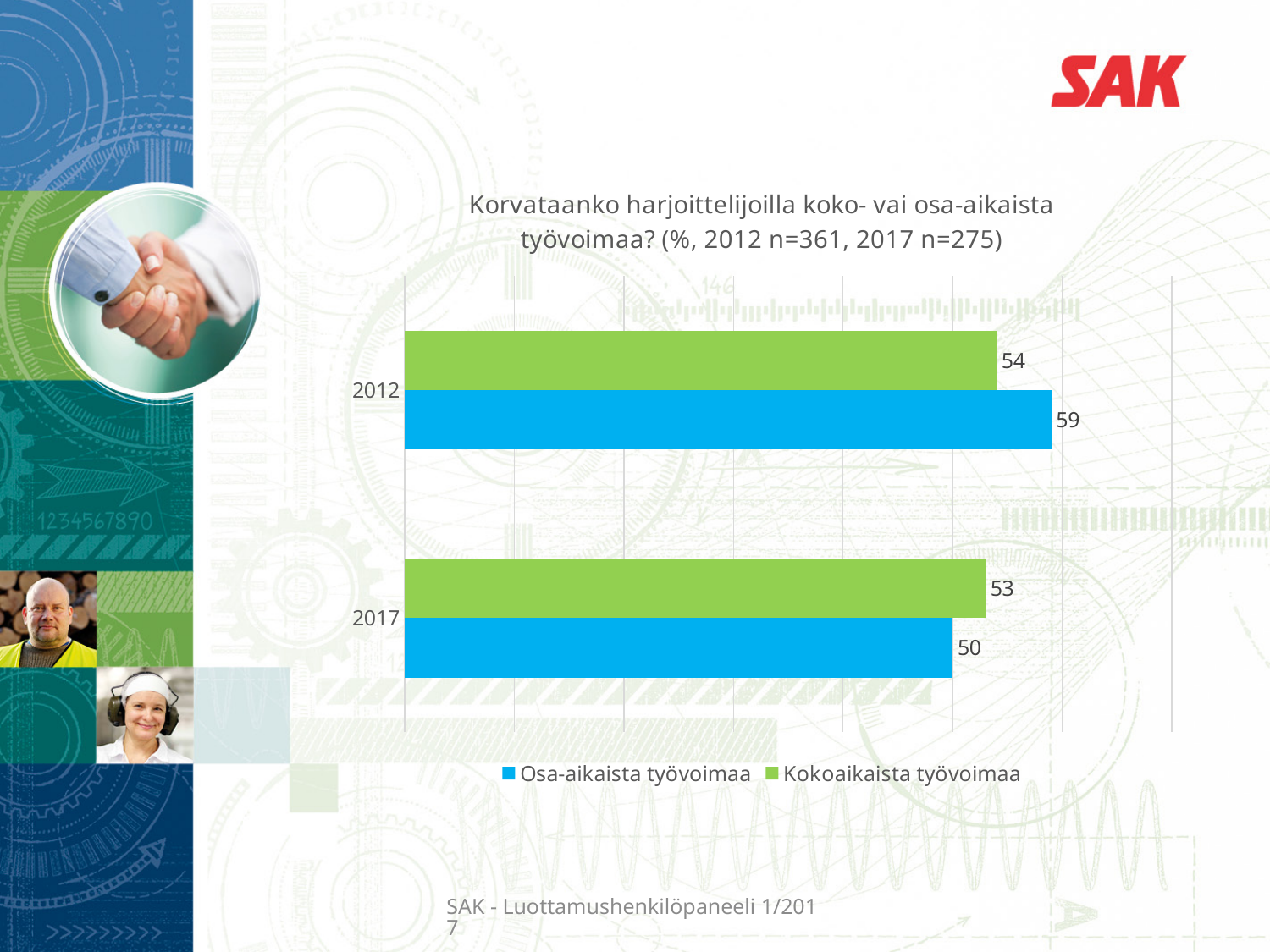
What kind of chart is shown on the slide? Bar chart How many series does the legend list? 2 How many year categories are shown on the chart? 2 What is the value for Osa-aikaista työvoimaa in 2017? 50 In 2017, which is larger: Osa-aikaista työvoimaa or Kokoaikaista työvoimaa? Kokoaikaista työvoimaa What is the difference between the Osa-aikaista työvoimaa values for 2012 and 2017? 9 In 2012, which is larger: Osa-aikaista työvoimaa or Kokoaikaista työvoimaa? Osa-aikaista työvoimaa What is the value for Kokoaikaista työvoimaa in 2012? 54 What is the value for Kokoaikaista työvoimaa in 2017? 53 What is the value for Osa-aikaista työvoimaa in 2012? 59 Which colour represents Kokoaikaista työvoimaa in the chart? Green Which year has the higher value for Osa-aikaista työvoimaa? 2012